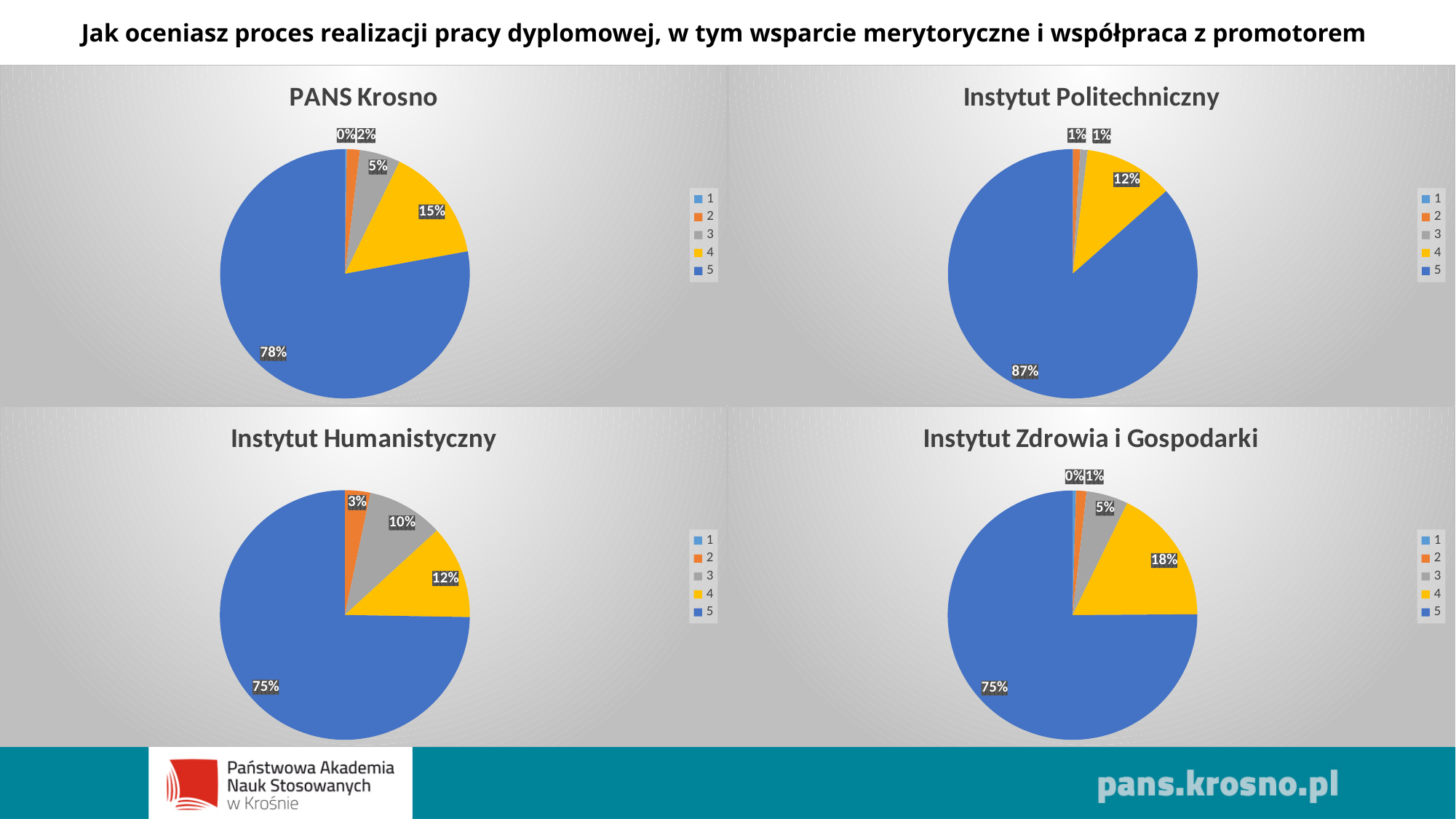
In the Instytut Zdrowia i Gospodarki pie chart, what share does category 4 have? 18% In the PANS Krosno pie chart, what share does category 4 have? 15% In the Instytut Humanistyczny pie chart, what share does category 3 have? 10% In the PANS Krosno pie chart, what is the difference between the shares of category 5 and category 4? 63% In the Instytut Politechniczny pie chart, what share does category 5 have? 87% How many entries does the legend of the Instytut Politechniczny chart list? 5 In the Instytut Politechniczny pie chart, what share does category 4 have? 12% What type of chart is used for Instytut Humanistyczny? Pie chart In the Instytut Zdrowia i Gospodarki pie chart, which category has the largest slice? 5 How many pie charts are shown on the slide? 4 In the Instytut Humanistyczny pie chart, which is larger, the share of category 3 or category 4? 4 In the PANS Krosno pie chart, what share does category 5 have? 78%